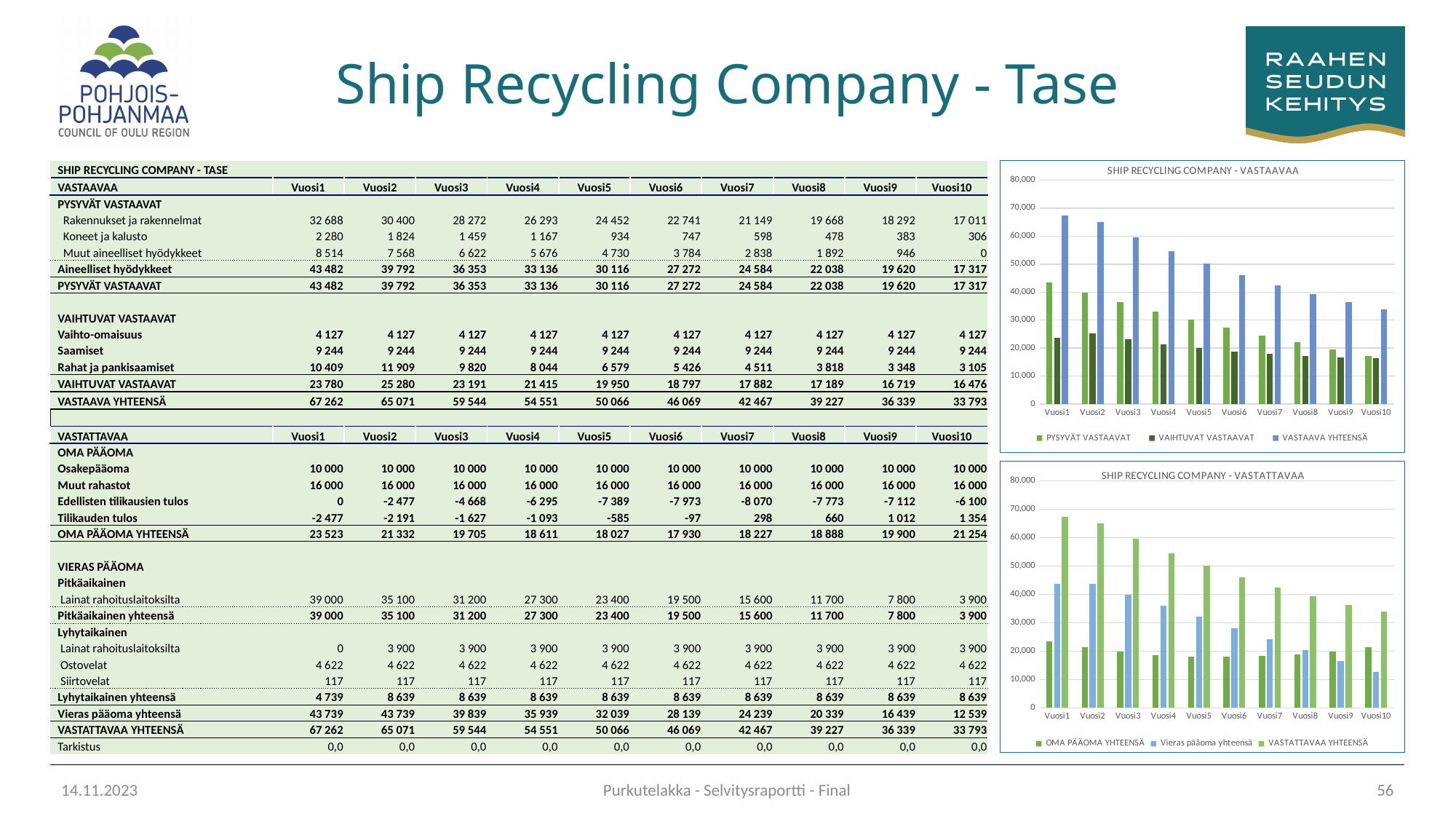
How many categories are shown on the x axis of the 'SHIP RECYCLING COMPANY - VASTAAVAA' chart? 10 In the 'SHIP RECYCLING COMPANY - VASTAAVAA' chart, is the PYSYVÄT VASTAAVAT value for Vuosi10 greater or less than 20,000? less In the 'SHIP RECYCLING COMPANY - VASTAAVAA' chart, which is larger for Vuosi5: PYSYVÄT VASTAAVAT or VAIHTUVAT VASTAAVAT? PYSYVÄT VASTAAVAT In the 'SHIP RECYCLING COMPANY - VASTATTAVAA' chart, which is larger for Vuosi10: OMA PÄÄOMA YHTEENSÄ or Vieras pääoma yhteensä? OMA PÄÄOMA YHTEENSÄ How many series does the legend of the 'SHIP RECYCLING COMPANY - VASTATTAVAA' chart list? 3 In the 'SHIP RECYCLING COMPANY - VASTAAVAA' chart, which year has the lowest VASTAAVA YHTEENSÄ value? Vuosi10 What kind of chart is the 'SHIP RECYCLING COMPANY - VASTAAVAA' chart? bar chart In the 'SHIP RECYCLING COMPANY - VASTATTAVAA' chart, is the 'Vieras pääoma yhteensä' value for Vuosi10 greater or less than 20,000? less In the 'SHIP RECYCLING COMPANY - VASTAAVAA' chart, does the VASTAAVA YHTEENSÄ series rise or fall from Vuosi1 to Vuosi10? fall How many series does the legend of the 'SHIP RECYCLING COMPANY - VASTAAVAA' chart list? 3 In the 'SHIP RECYCLING COMPANY - VASTAAVAA' chart, is the VASTAAVA YHTEENSÄ value for Vuosi1 greater or less than 60,000? greater What kind of chart is the 'SHIP RECYCLING COMPANY - VASTATTAVAA' chart? bar chart